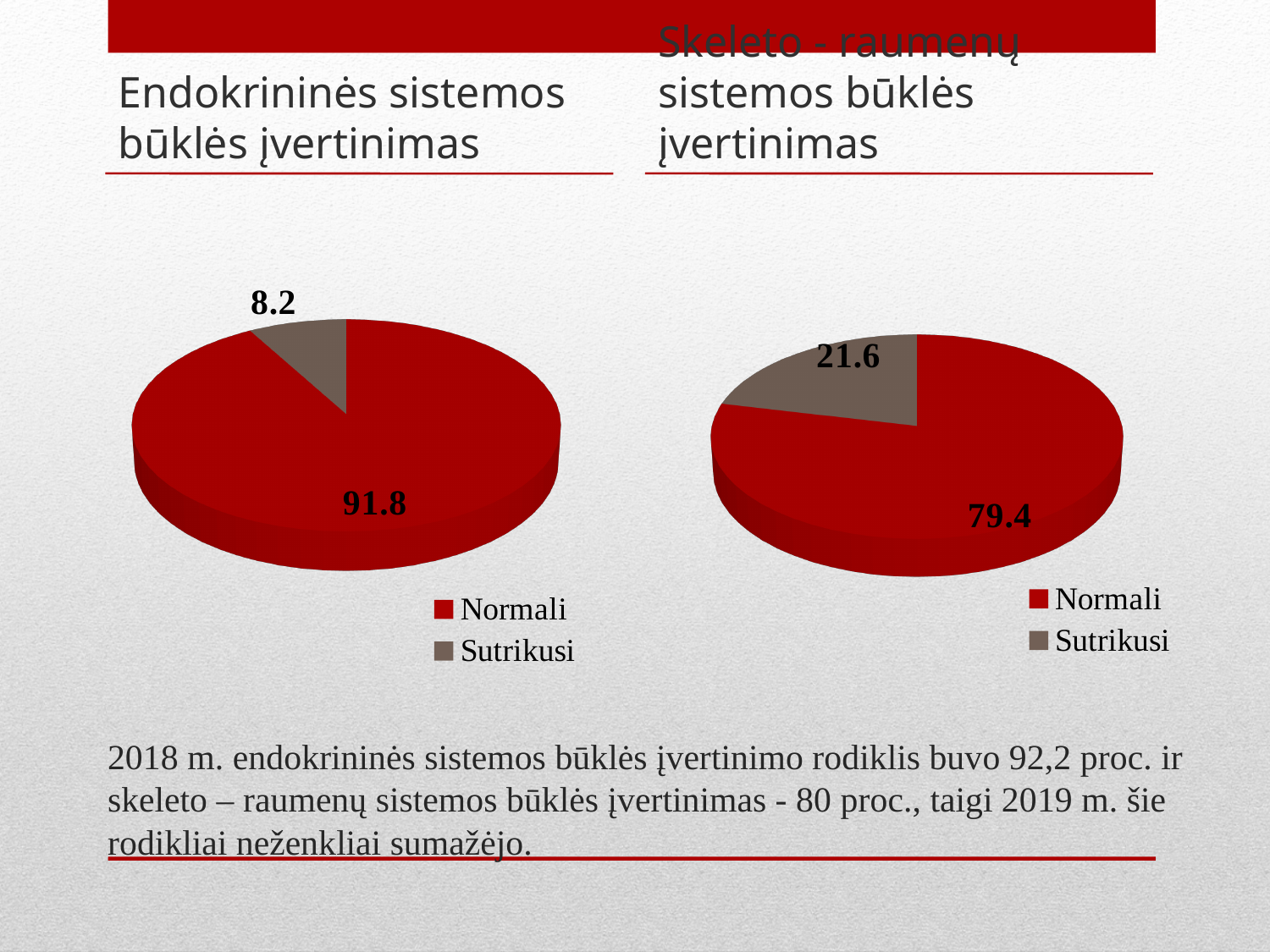
In the left chart (Endokrininės sistemos būklės įvertinimas), what is the difference between the Normali and Sutrikusi values? 83.6 In the left chart (Endokrininės sistemos būklės įvertinimas), what is the value for Sutrikusi? 8.2 In the left chart (Endokrininės sistemos būklės įvertinimas), which category has the largest slice? Normali In the right chart (Skeleto - raumenų sistemos būklės įvertinimas), which category has the smallest slice? Sutrikusi Is the Sutrikusi value larger in the left chart (Endokrininės) or the right chart (Skeleto - raumenų)? Right chart (Skeleto - raumenų) What type of chart is used on the left (Endokrininės sistemos būklės įvertinimas)? Pie chart In the right chart (Skeleto - raumenų sistemos būklės įvertinimas), what is the difference between the Normali and Sutrikusi values? 57.8 In the left chart (Endokrininės sistemos būklės įvertinimas), what colour is the Sutrikusi slice? Grey In the left chart (Endokrininės sistemos būklės įvertinimas), what is the value for Normali? 91.8 In the right chart (Skeleto - raumenų sistemos būklės įvertinimas), what is the value for Normali? 79.4 In the right chart (Skeleto - raumenų sistemos būklės įvertinimas), what is the value for Sutrikusi? 21.6 How many categories does the right chart (Skeleto - raumenų sistemos būklės įvertinimas) show? 2